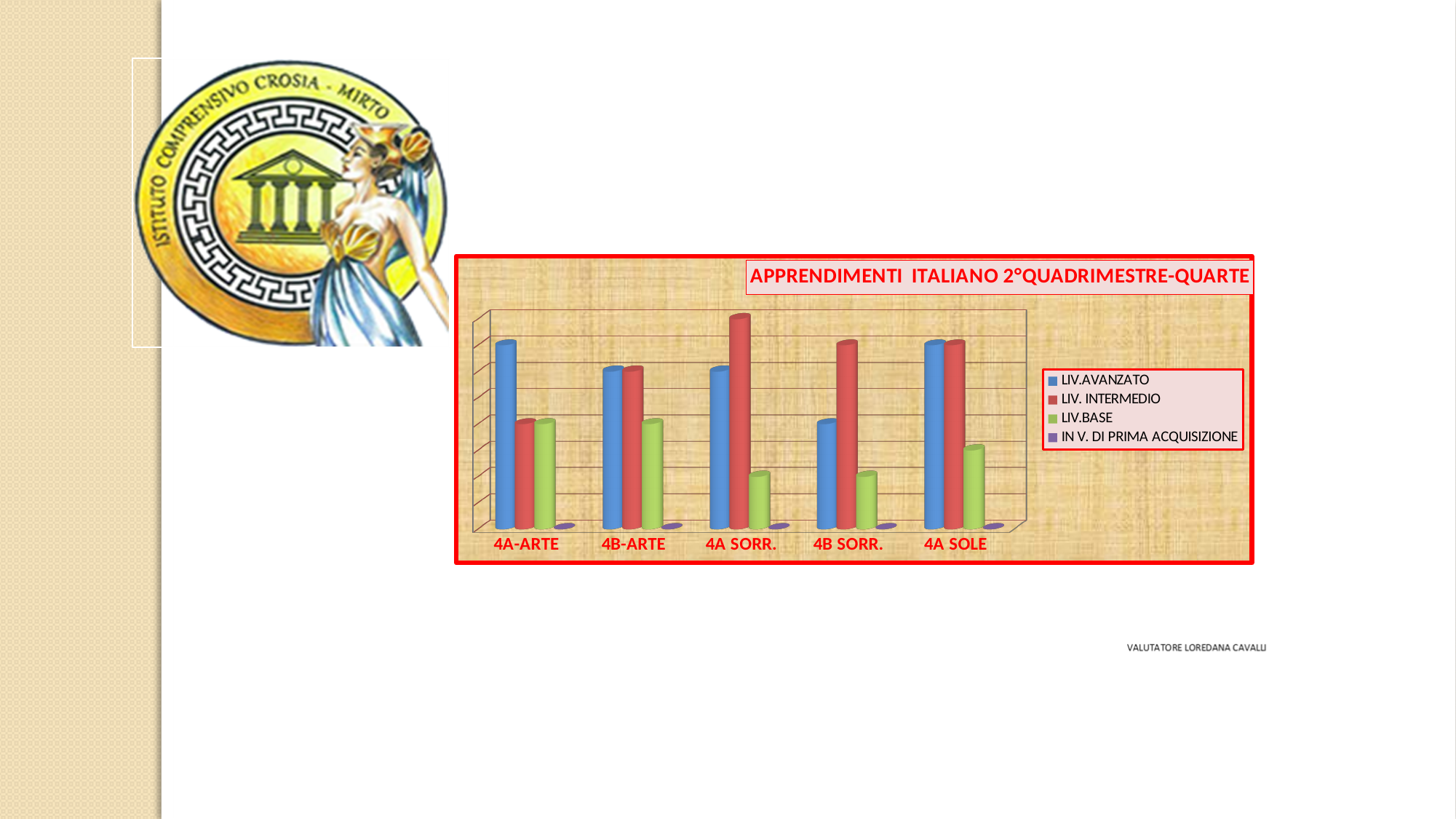
Which class has the lowest LIV. INTERMEDIO bar? 4A-ARTE What kind of chart is shown on the slide? bar chart Which class has the lowest LIV.AVANZATO bar? 4B SORR. Which series is shown in green in the legend? LIV.BASE What is the title of the chart? APPRENDIMENTI ITALIANO 2°QUADRIMESTRE-QUARTE For 4A SORR., which is larger: LIV.AVANZATO or LIV. INTERMEDIO? LIV. INTERMEDIO How many classes (categories) are shown on the x axis? 5 Which class has the tallest bar of any series in the chart? 4A SORR. Which class has the highest LIV. INTERMEDIO bar? 4A SORR. For 4B SORR., which is larger: LIV.AVANZATO or LIV. INTERMEDIO? LIV. INTERMEDIO For 4A-ARTE, which is larger: LIV.AVANZATO or LIV. INTERMEDIO? LIV.AVANZATO How many series does the legend list? 4